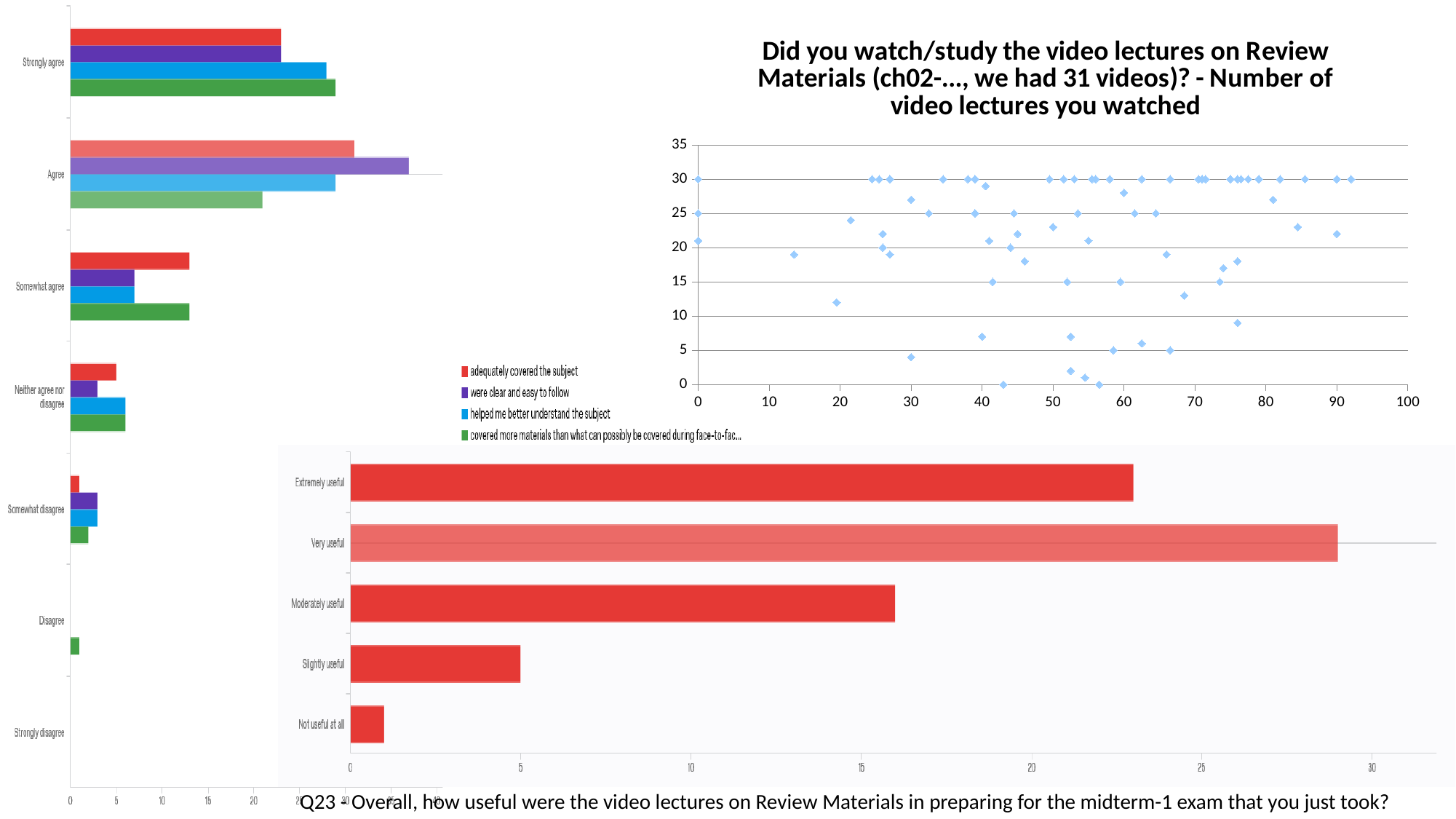
In the bottom-right chart (Q23, usefulness of video lectures), which is larger: Extremely useful or Moderately useful? Extremely useful In the left-hand chart (agreement levels), is the value for 'were clear and easy to follow' in the Agree category greater or less than 30? greater In the bottom-right chart (Q23, usefulness of video lectures), what is the value for Slightly useful? 5 How many series does the legend of the left-hand chart (agreement levels) list? 4 In the bottom-right chart (Q23, usefulness of video lectures), which category has the lowest value? Not useful at all What kind of chart is the left-hand chart showing agreement levels? bar chart In the bottom-right chart (Q23, usefulness of video lectures), which category has the highest value? Very useful What kind of chart is the top-right chart titled 'Did you watch/study the video lectures on Review Materials...'? scatter chart In the bottom-right chart (Q23, usefulness of video lectures), is the value for Very useful greater or less than 25? greater How many categories does the left-hand chart (agreement levels) show? 7 In the bottom-right chart (Q23, usefulness of video lectures), is the value for Moderately useful greater or less than 15? greater How many categories does the bottom-right chart (Q23, usefulness of video lectures) show? 5